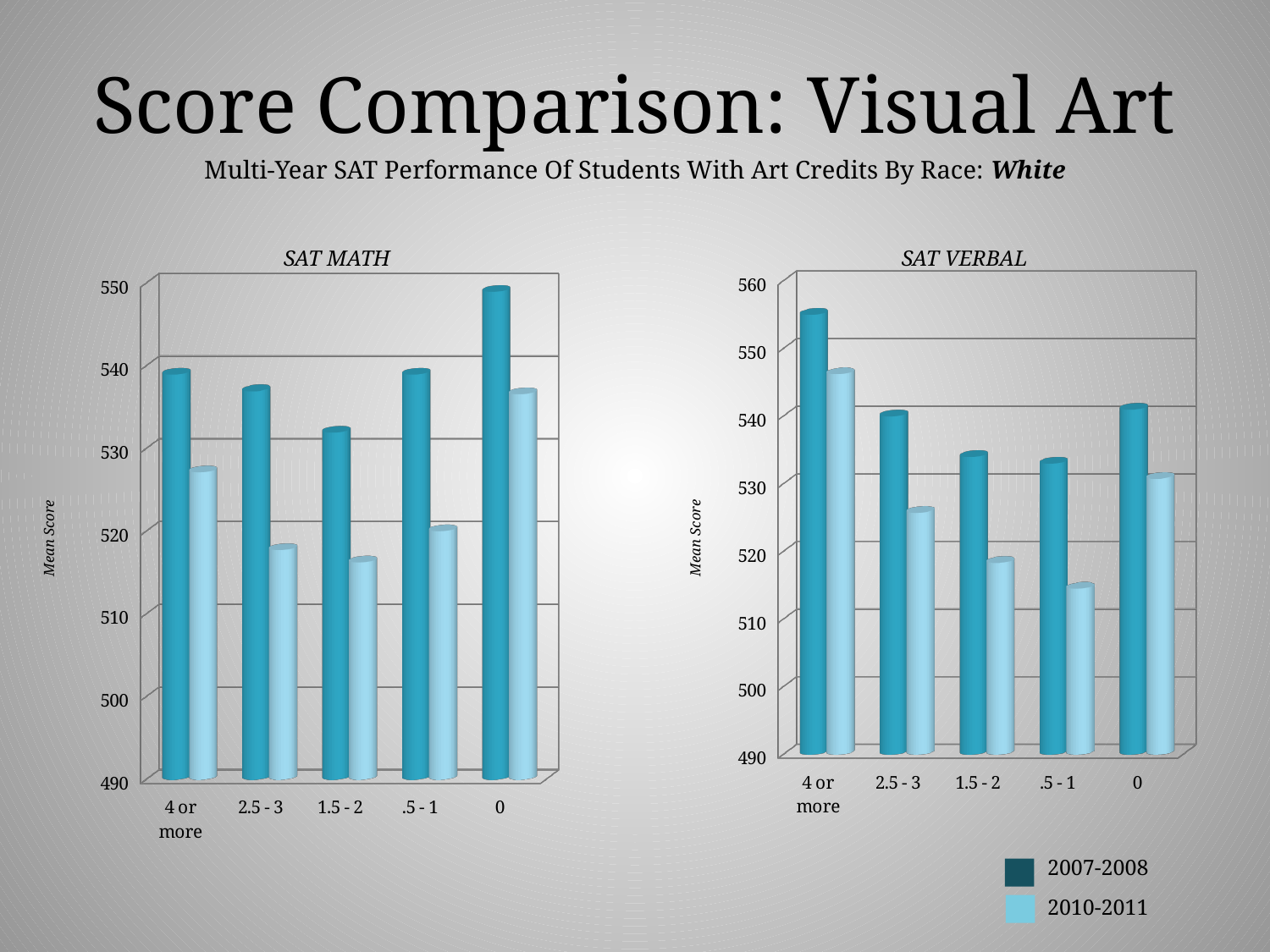
On the SAT VERBAL chart, is the 2007-2008 value for the 4 or more category greater or less than 550? greater On the SAT MATH chart, which category has the highest 2007-2008 score? 0 On the SAT MATH chart, is the 2010-2011 value for the 1.5 - 2 category greater or less than 520? less How many credit categories are shown on the SAT MATH chart? 5 How many series does the legend list for the charts? 2 On the SAT VERBAL chart, is the 2010-2011 value for the .5 - 1 category greater or less than 520? less On the SAT VERBAL chart, which category has the lowest 2010-2011 score? .5 - 1 What is the label on the vertical axis of the SAT MATH chart? Mean Score On the SAT VERBAL chart, which is larger for 2010-2011: the 4 or more category or the 0 category? 4 or more On the SAT VERBAL chart, which category has the highest 2007-2008 score? 4 or more What kind of chart is the SAT VERBAL chart? bar chart